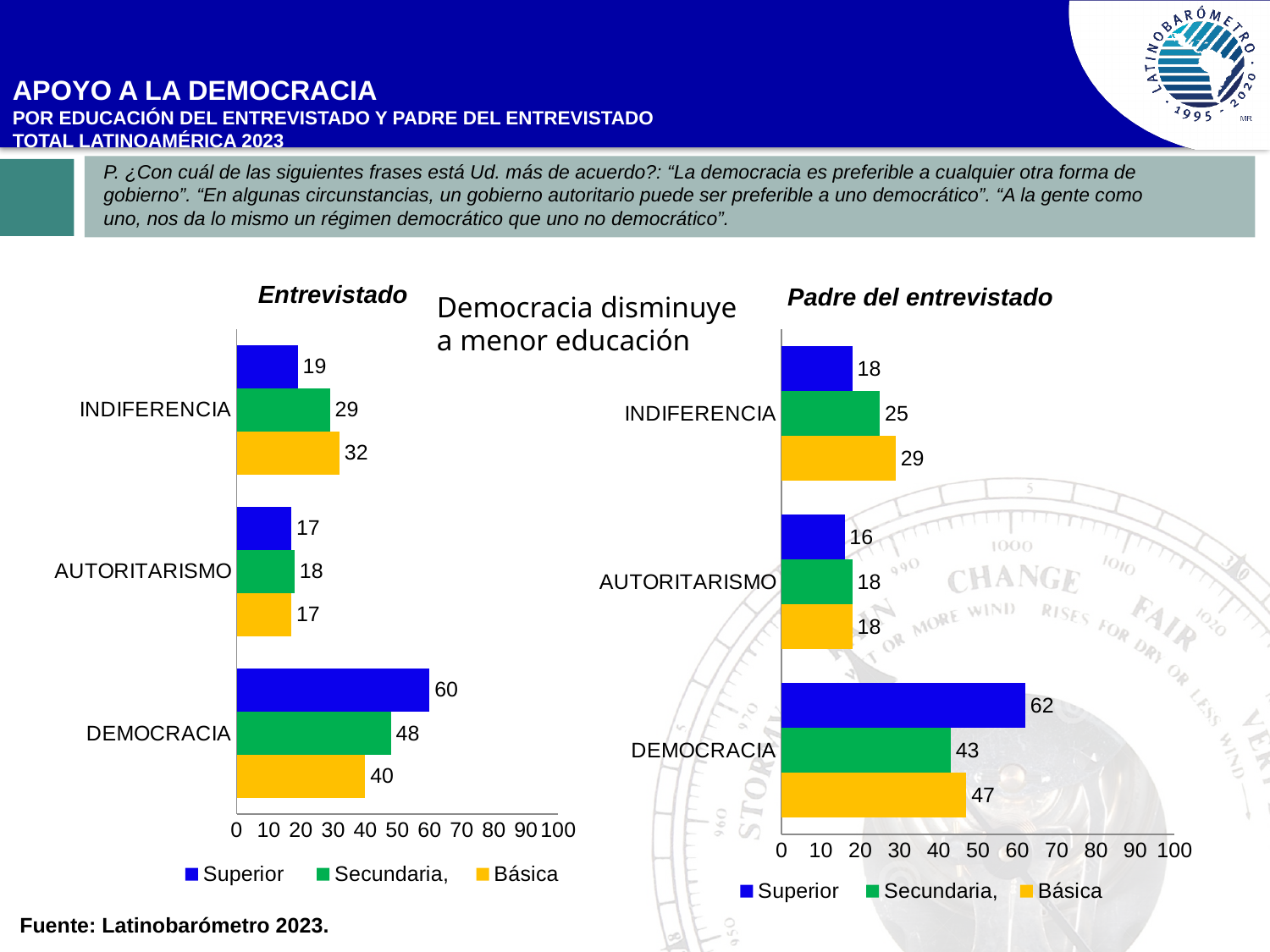
In the 'Padre del entrevistado' chart, which is larger for DEMOCRACIA: Secundaria or Básica? Básica In the 'Padre del entrevistado' chart, which category has the lowest value for Superior? AUTORITARISMO In the 'Entrevistado' chart, what is the value for Superior in the DEMOCRACIA category? 60 In the 'Entrevistado' chart, is the Secundaria value for DEMOCRACIA greater or less than 40? greater In the 'Entrevistado' chart, which category has the highest value for Superior? DEMOCRACIA In the 'Entrevistado' chart, what is the value for Básica in the INDIFERENCIA category? 32 In the 'Padre del entrevistado' chart, what is the value for Básica in the DEMOCRACIA category? 47 How many categories are shown in the 'Padre del entrevistado' chart? 3 In the 'Padre del entrevistado' chart, what is the value for Secundaria in the INDIFERENCIA category? 25 In the 'Entrevistado' chart, what is the difference between the Superior and Básica values for DEMOCRACIA? 20 How many series does the legend of the 'Entrevistado' chart list? 3 What type of chart is the 'Entrevistado' chart? Bar chart